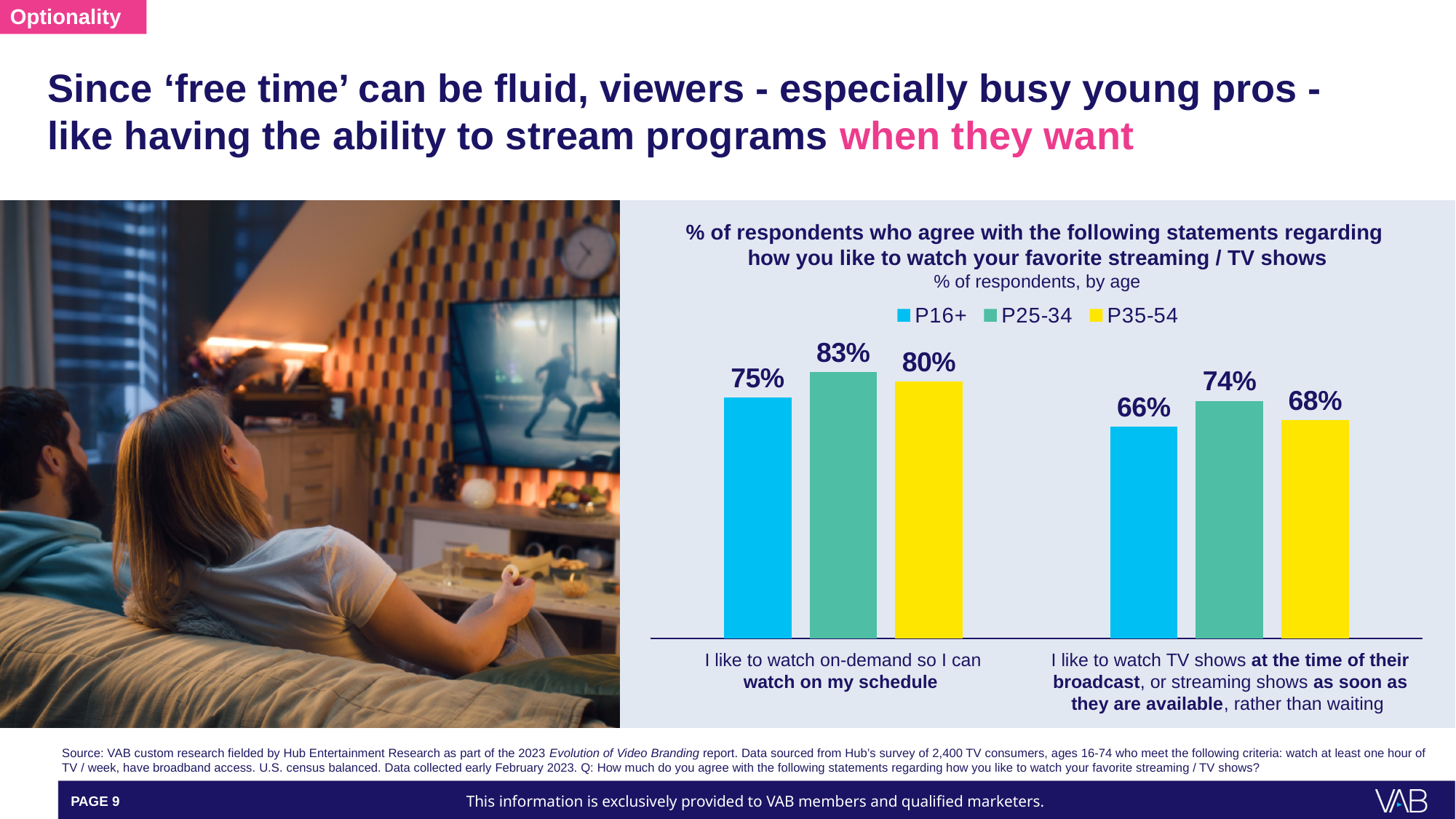
What is the difference in percentage points between P25-34 and P16+ for 'I like to watch on-demand so I can watch on my schedule'? 8 percentage points What kind of chart is shown on the slide? Bar chart What percentage of P16+ respondents agree with 'I like to watch TV shows at the time of their broadcast, or streaming shows as soon as they are available, rather than waiting'? 66% What is the difference in percentage points between P25-34 and P35-54 for 'I like to watch TV shows at the time of their broadcast, or streaming shows as soon as they are available, rather than waiting'? 6 percentage points Which is larger: the P35-54 value for watching on-demand on my schedule, or the P35-54 value for watching at the time of broadcast? Watching on-demand on my schedule (80%) How many statements (categories) are shown on the x axis of the chart? 2 What percentage of P25-34 respondents agree with 'I like to watch on-demand so I can watch on my schedule'? 83% What percentage of P35-54 respondents agree with 'I like to watch on-demand so I can watch on my schedule'? 80% How many series does the legend list? 3 Which age group has the lowest agreement with 'I like to watch on-demand so I can watch on my schedule'? P16+ Which age group has the highest agreement with 'I like to watch TV shows at the time of their broadcast, or streaming shows as soon as they are available, rather than waiting'? P25-34 Which colour represents the P35-54 series in the chart? Yellow